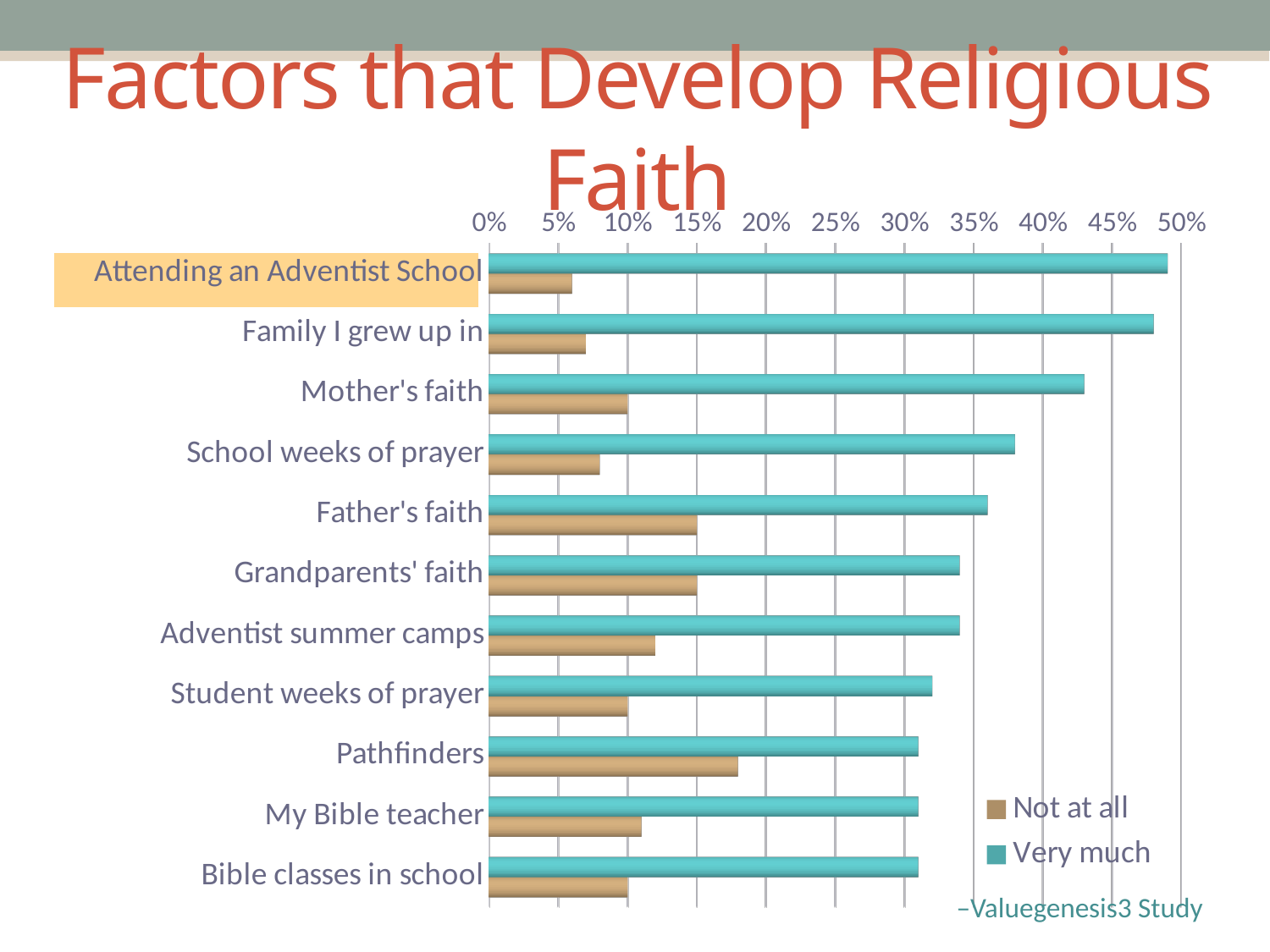
How many categories (factors) are plotted on the chart? 11 Which has the larger 'Very much' value, Mother's faith or Father's faith? Mother's faith Is the 'Not at all' value for Pathfinders greater or less than 15%? greater Is the 'Very much' value for Father's faith greater or less than 30%? greater Is the 'Very much' value for School weeks of prayer greater or less than 40%? less Which has the larger 'Not at all' value, Father's faith or Mother's faith? Father's faith Which series is shown in teal on the chart? Very much What kind of chart is shown on the slide? Bar chart How many series does the legend list? 2 Which category has the highest 'Not at all' value? Pathfinders